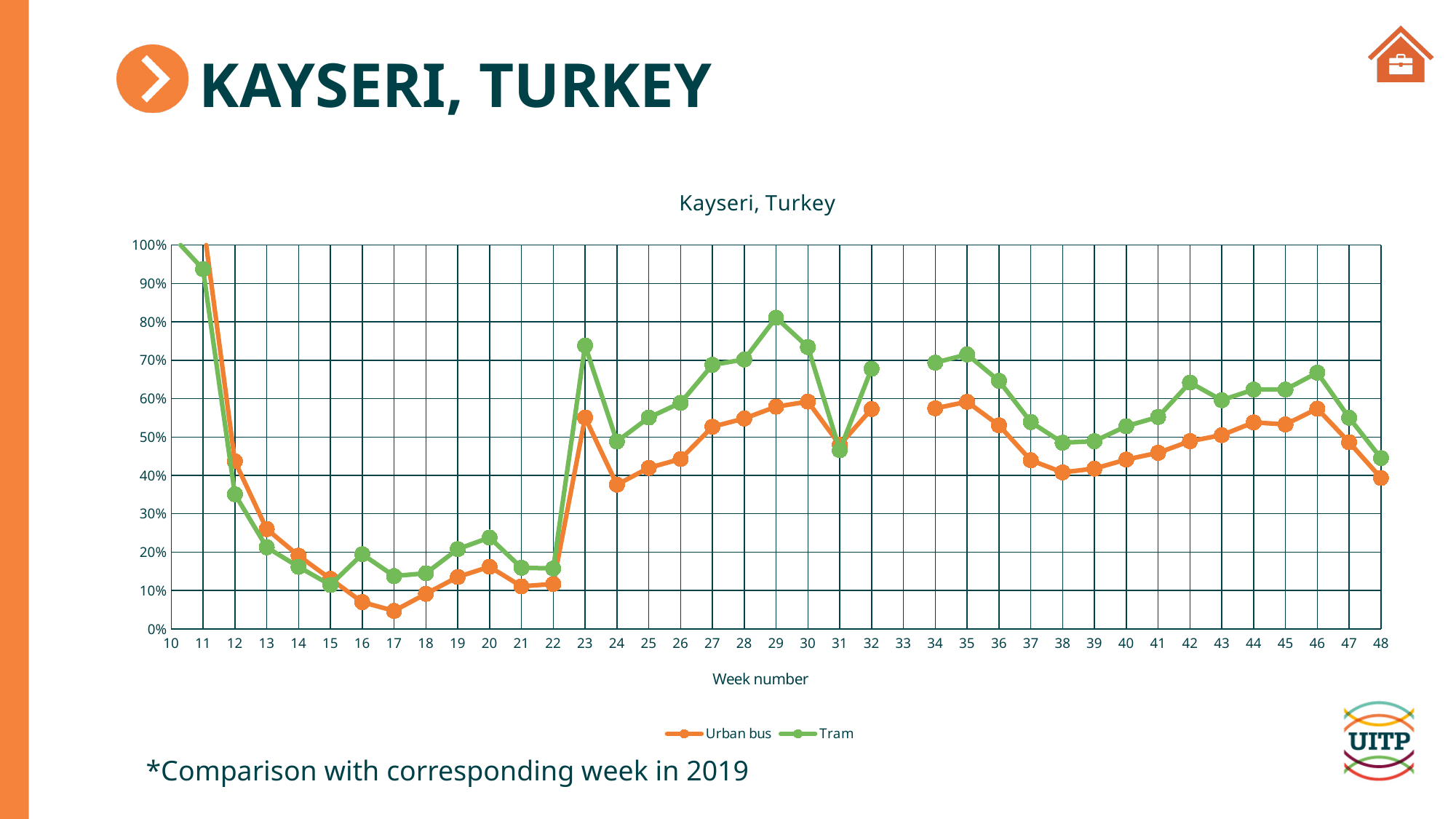
Does the Tram series rise or fall from week 23 to week 29? Rise Is the Tram value for week 31 greater or less than 50%? less What are the two series named in the legend? Urban bus and Tram At week 12, which series has the higher value, Urban bus or Tram? Urban bus Is the Urban bus value for week 35 greater or less than 50%? greater In which week does the Urban bus series reach its lowest value? Week 17 How many series does the legend list? 2 At week 29, which series has the higher value, Urban bus or Tram? Tram What is the title of the x axis? Week number Is the Urban bus value for week 17 greater or less than 10%? less What kind of chart is shown on the slide? Line chart